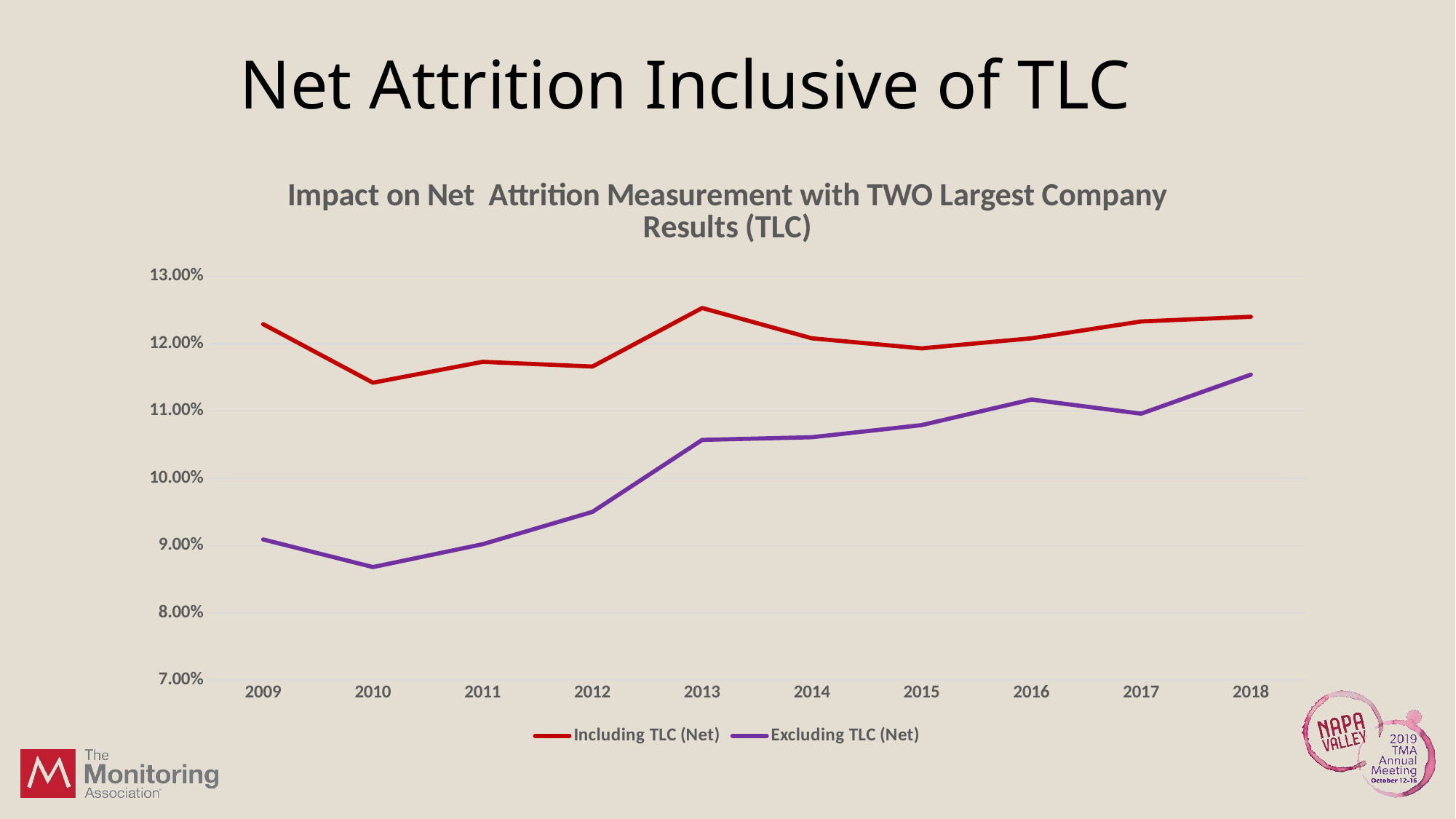
Does the Excluding TLC (Net) series generally rise or fall from 2009 to 2018? rise In which year is the Excluding TLC (Net) series at its highest? 2018 In which year is the Including TLC (Net) series at its lowest? 2010 How many series does the legend list? 2 In which year is the Excluding TLC (Net) series at its lowest? 2010 How many years are plotted along the x axis? 10 Is the value for Including TLC (Net) in 2013 greater or less than 12.00%? greater Is the value for Excluding TLC (Net) in 2009 greater or less than 10.00%? less What kind of chart is shown on the slide? line chart Which colour is used for the Including TLC (Net) series? red Which series has the higher value in 2015, Including TLC (Net) or Excluding TLC (Net)? Including TLC (Net) Is the value for Excluding TLC (Net) in 2018 greater or less than 11.00%? greater